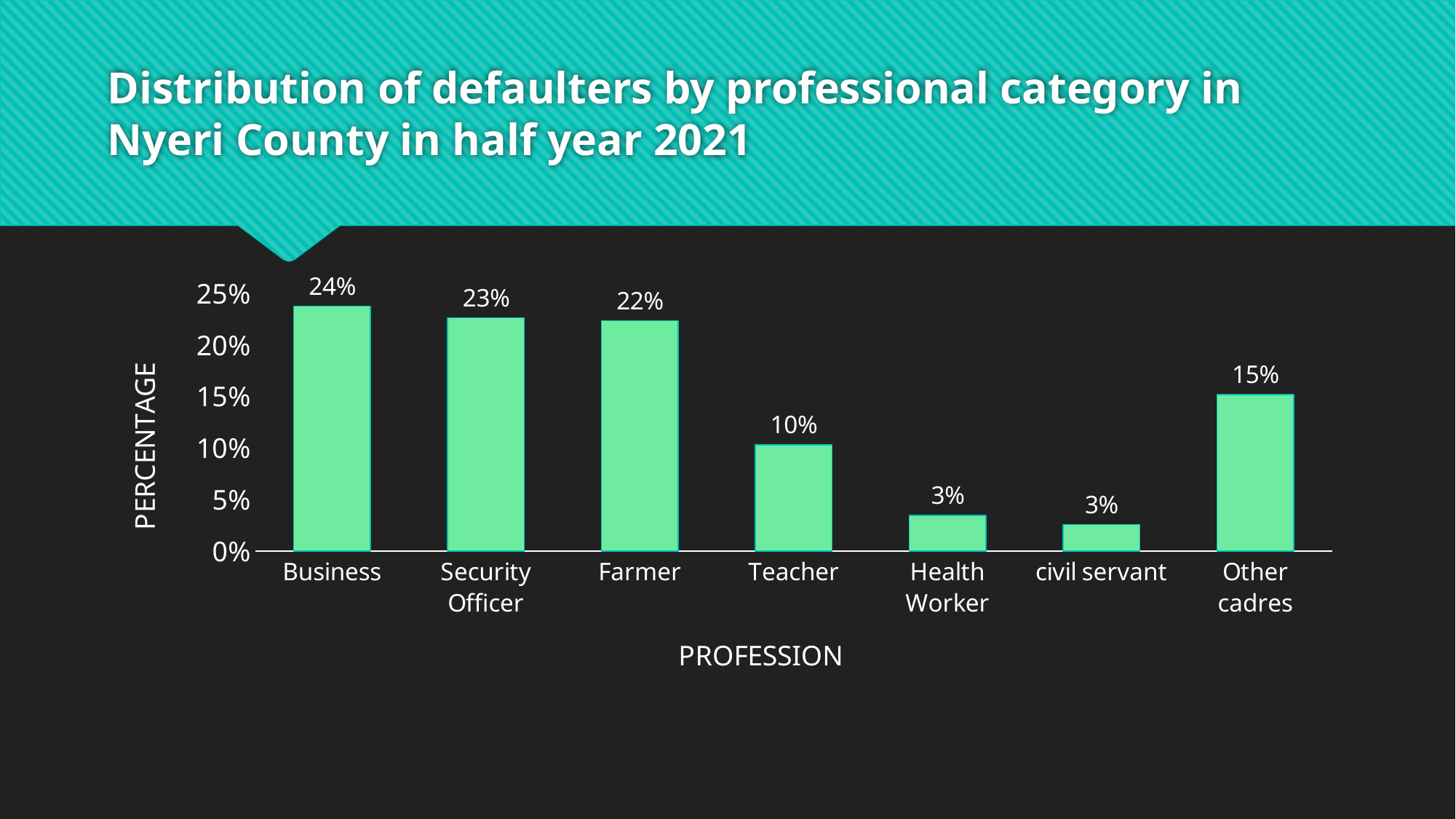
Is the value for Farmer greater or less than 20%? greater What is the label of the horizontal axis? PROFESSION What is the value shown for Teacher? 10% How many professional categories are shown on the x axis? 7 What percentage is shown for Other cadres? 15% Which professional category has the highest percentage of defaulters? Business What percentage of defaulters are in the Business category? 24% Which is larger, the value for Security Officer or the value for Other cadres? Security Officer What is the difference in percentage between Business and Farmer? 2% What is the label of the vertical axis? PERCENTAGE What kind of chart is shown on the slide? Bar chart What is the difference between the Other cadres value and the Teacher value? 5%